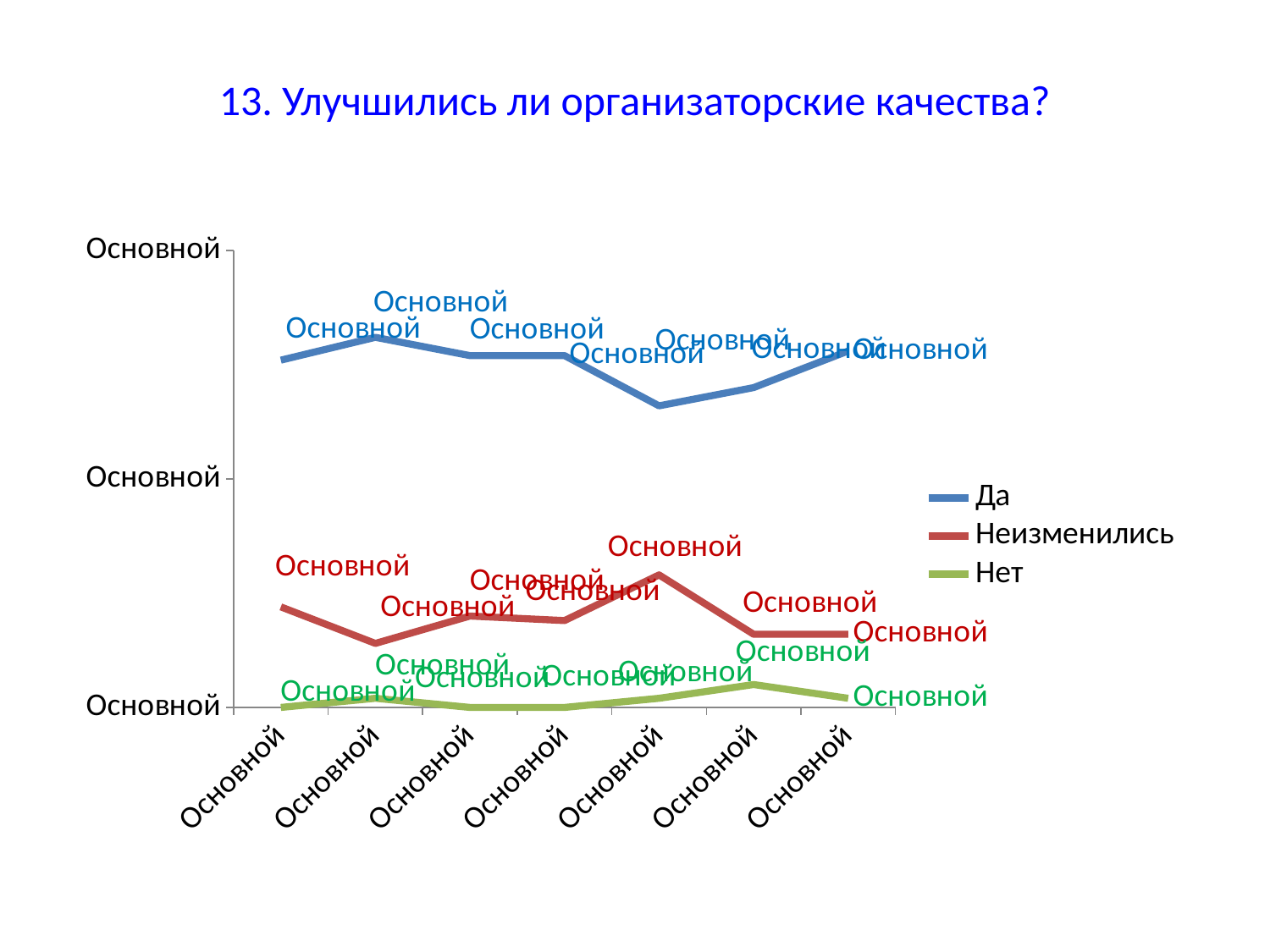
How many series does the legend list? 3 Does the Да line rise or fall from the fourth point to the fifth point from the left? fall At the leftmost point, which is larger: the value for Да or the value for Нет? Да What kind of chart is shown on the slide? line chart How many data points does each line in the chart have? 7 Does the Да line rise or fall from the fifth point to the seventh point from the left? rise At the rightmost point, which is larger: the value for Неизменились or the value for Нет? Неизменились What are the entries in the chart's legend? Да, Неизменились, Нет Which series has the highest values across the chart? Да Does the Неизменились line rise or fall from the fifth point to the sixth point from the left? fall Which series has the lowest values across the chart? Нет What is the title of the slide above the chart? 13. Улучшились ли организаторские качества?